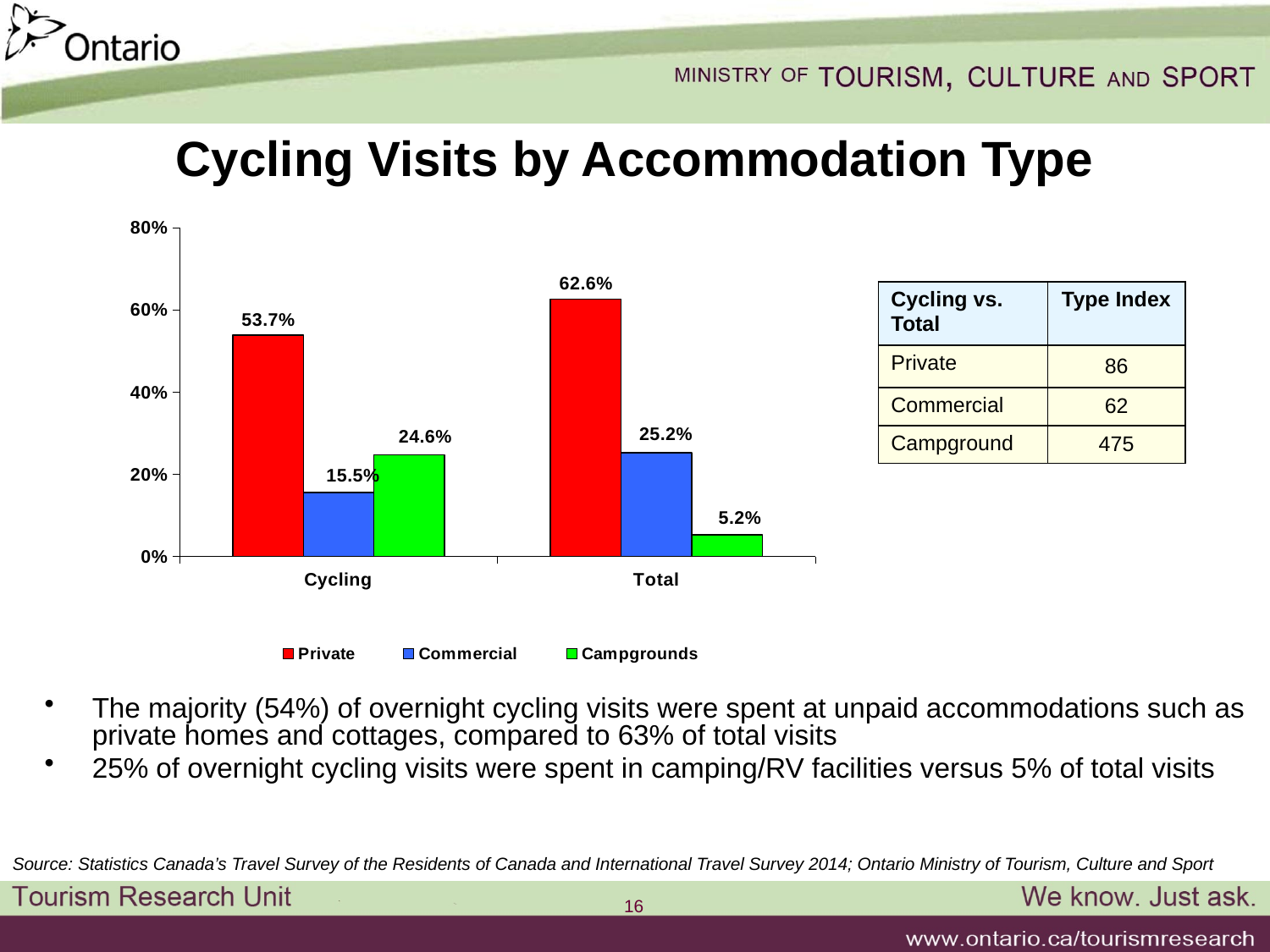
Which series has the highest value in the Total group? Private What is the value for Campgrounds in the Total group? 5.2% What colour represents the Commercial series? Blue Which series has the lowest value in the Cycling group? Commercial What kind of chart is shown? Bar chart Is the value for Commercial in the Total group greater or less than 20%? greater How many series does the legend list? 3 How many categories are shown on the x axis? 2 What is the difference between the Private values for Total and Cycling? 8.9% Which is larger: Campgrounds for Cycling or Campgrounds for Total? Campgrounds for Cycling What is the value for Commercial in the Cycling group? 15.5% What is the value for Private in the Cycling group? 53.7%